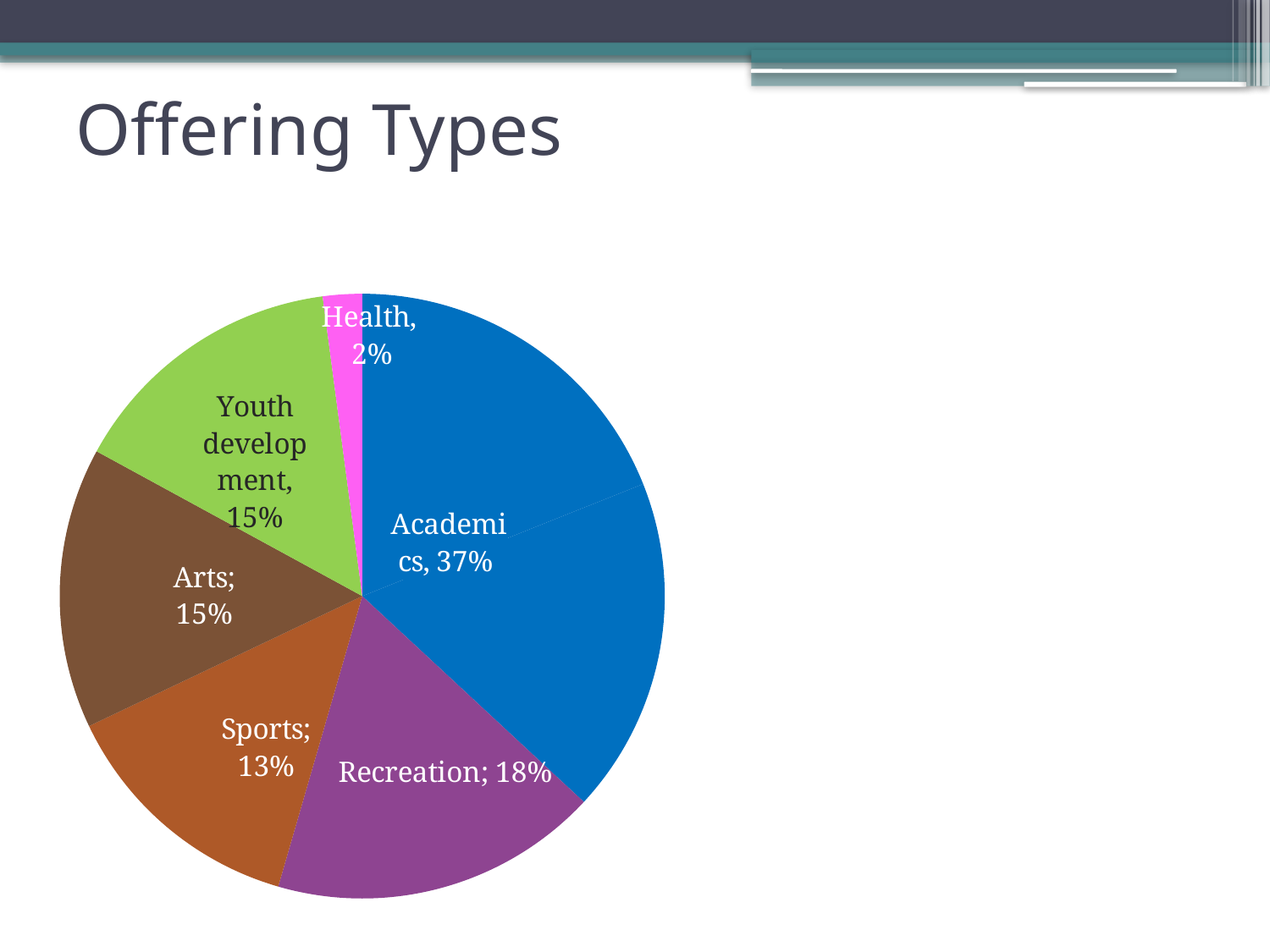
Which is larger, the Recreation slice or the Sports slice? Recreation What is the difference between the Academics and Recreation shares? 19% What share of the pie does Academics represent? 37% What is the value shown for Sports? 13% What is the title of the slide containing the pie chart? Offering Types How many categories are shown in the pie chart? 6 What type of chart is shown on the slide? pie chart What is the value shown for Health? 2% Which category has the largest slice of the pie? Academics Which category has the smallest slice of the pie? Health What is the value shown for Recreation? 18% What is the difference between the Youth development and Health shares? 13%